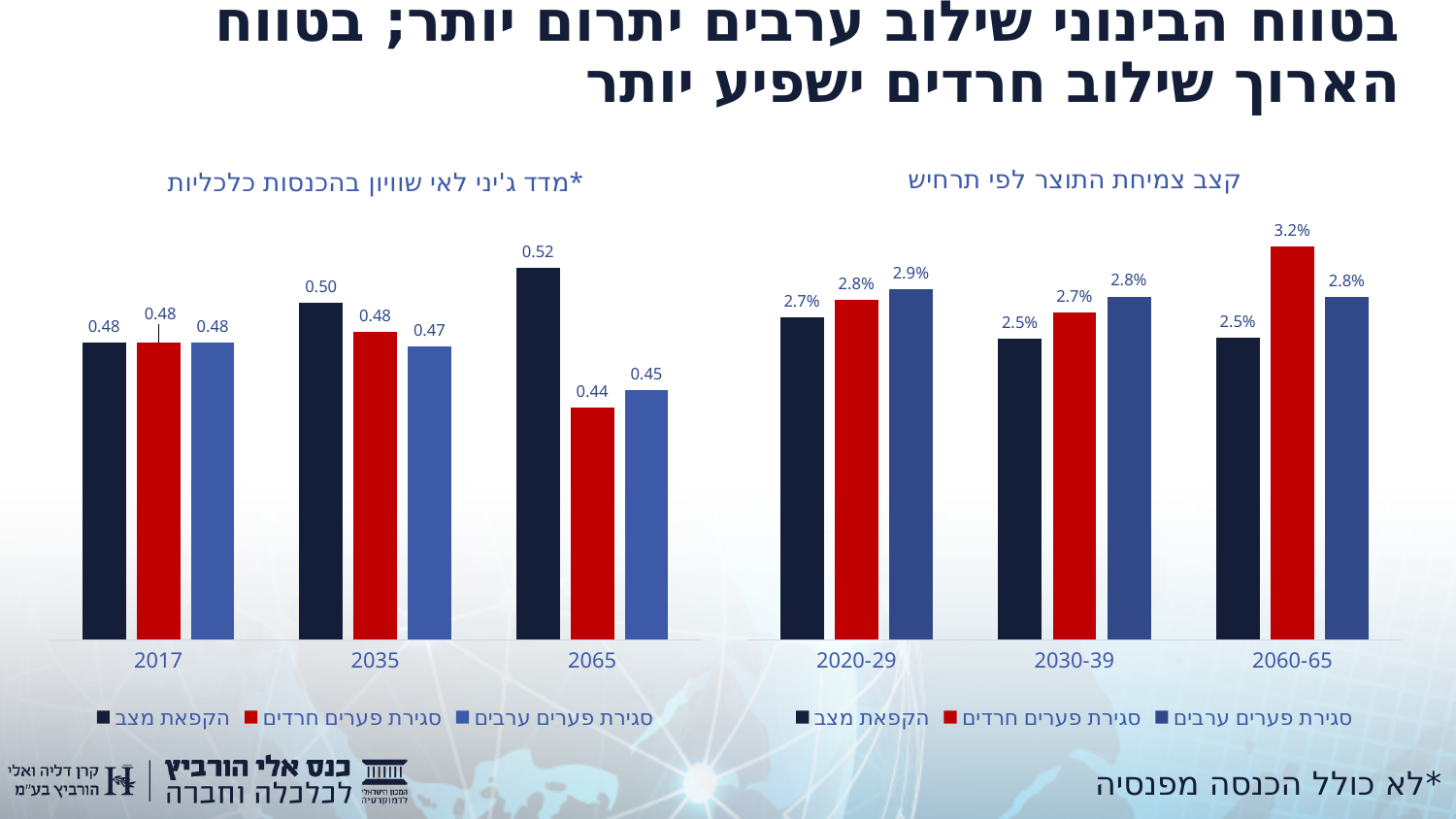
In the GDP growth rate chart (קצב צמיחת התוצר לפי תרחיש), how many period categories are shown on the x axis? 3 In the GDP growth rate chart (קצב צמיחת התוצר לפי תרחיש), which series has the highest value in 2060-65? סגירת פערים חרדים In the GDP growth rate chart (קצב צמיחת התוצר לפי תרחיש), what is the value for הקפאת מצב in 2020-29? 2.7% In the Gini index chart (מדד ג'יני לאי שוויון בהכנסות כלכליות), what is the value for הקפאת מצב in 2065? 0.52 In the Gini index chart (מדד ג'יני לאי שוויון בהכנסות כלכליות), how does the value for הקפאת מצב change from 2017 to 2065? It rises In the Gini index chart (מדד ג'יני לאי שוויון בהכנסות כלכליות), what is the difference between הקפאת מצב and סגירת פערים חרדים in 2065? 0.08 What type of chart is the Gini index chart on the left? Bar chart In the GDP growth rate chart (קצב צמיחת התוצר לפי תרחיש), what is the difference between סגירת פערים חרדים and הקפאת מצב in 2060-65? 0.7% In the Gini index chart (מדד ג'יני לאי שוויון בהכנסות כלכליות), which series has the lowest value in 2065? סגירת פערים חרדים In the GDP growth rate chart (קצב צמיחת התוצר לפי תרחיש), what is the value for סגירת פערים חרדים in 2060-65? 3.2% How many series does the legend of the GDP growth rate chart list? 3 In the Gini index chart (מדד ג'יני לאי שוויון בהכנסות כלכליות), what is the value for סגירת פערים ערבים in 2035? 0.47